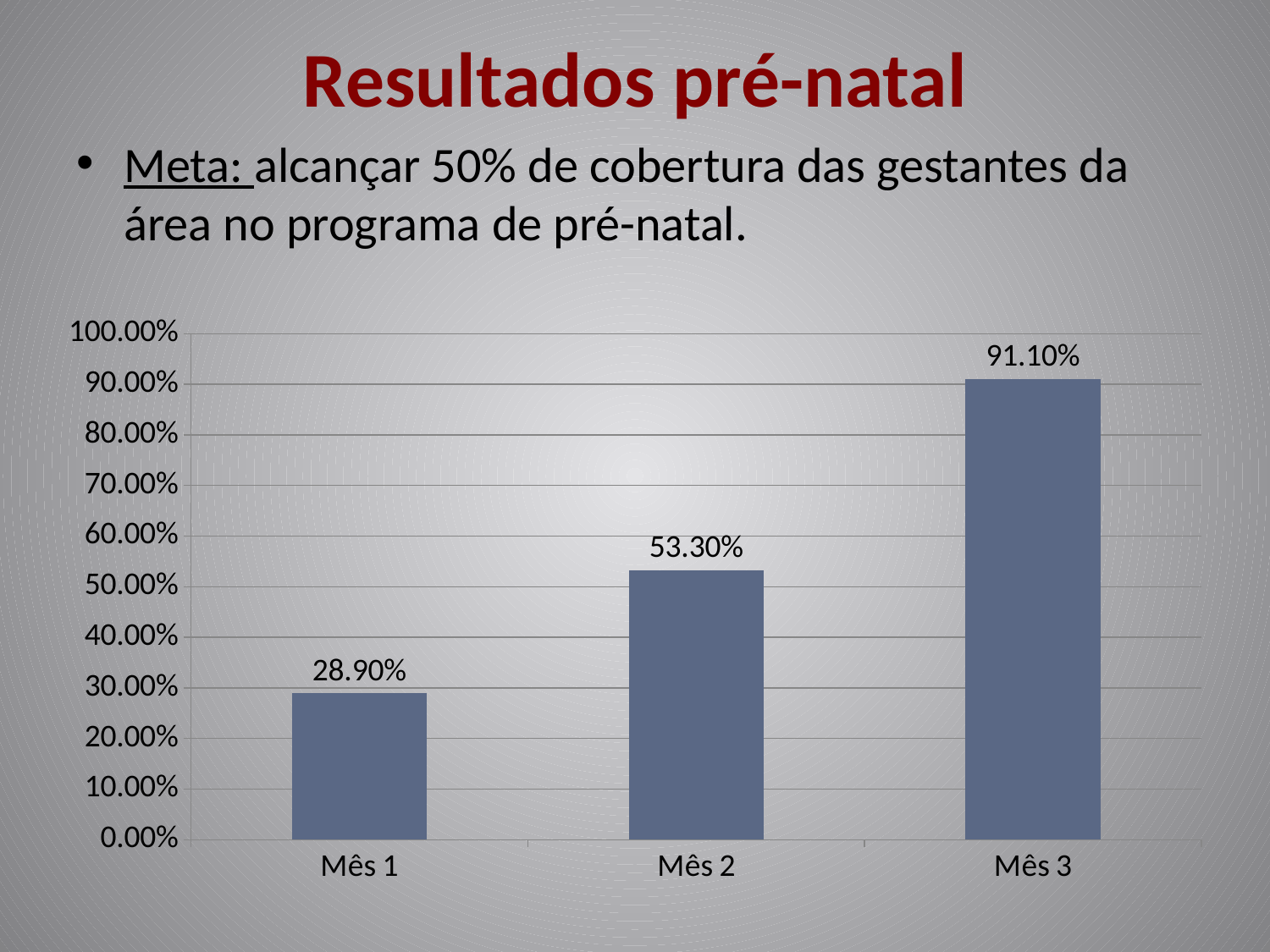
What is the value for Mês 2? 53.30% Which month has the lowest value? Mês 1 What is the value for Mês 1? 28.90% Which is larger, the value for Mês 2 or the value for Mês 3? Mês 3 Is the value for Mês 2 greater or less than 50.00%? greater Which month has the highest value? Mês 3 What is the value for Mês 3? 91.10% How many months are shown on the x axis? 3 Do the values rise or fall from Mês 1 to Mês 3? rise What kind of chart is shown on the slide? bar chart What is the difference between the values for Mês 2 and Mês 1? 24.40% What is the difference between the values for Mês 3 and Mês 1? 62.20%